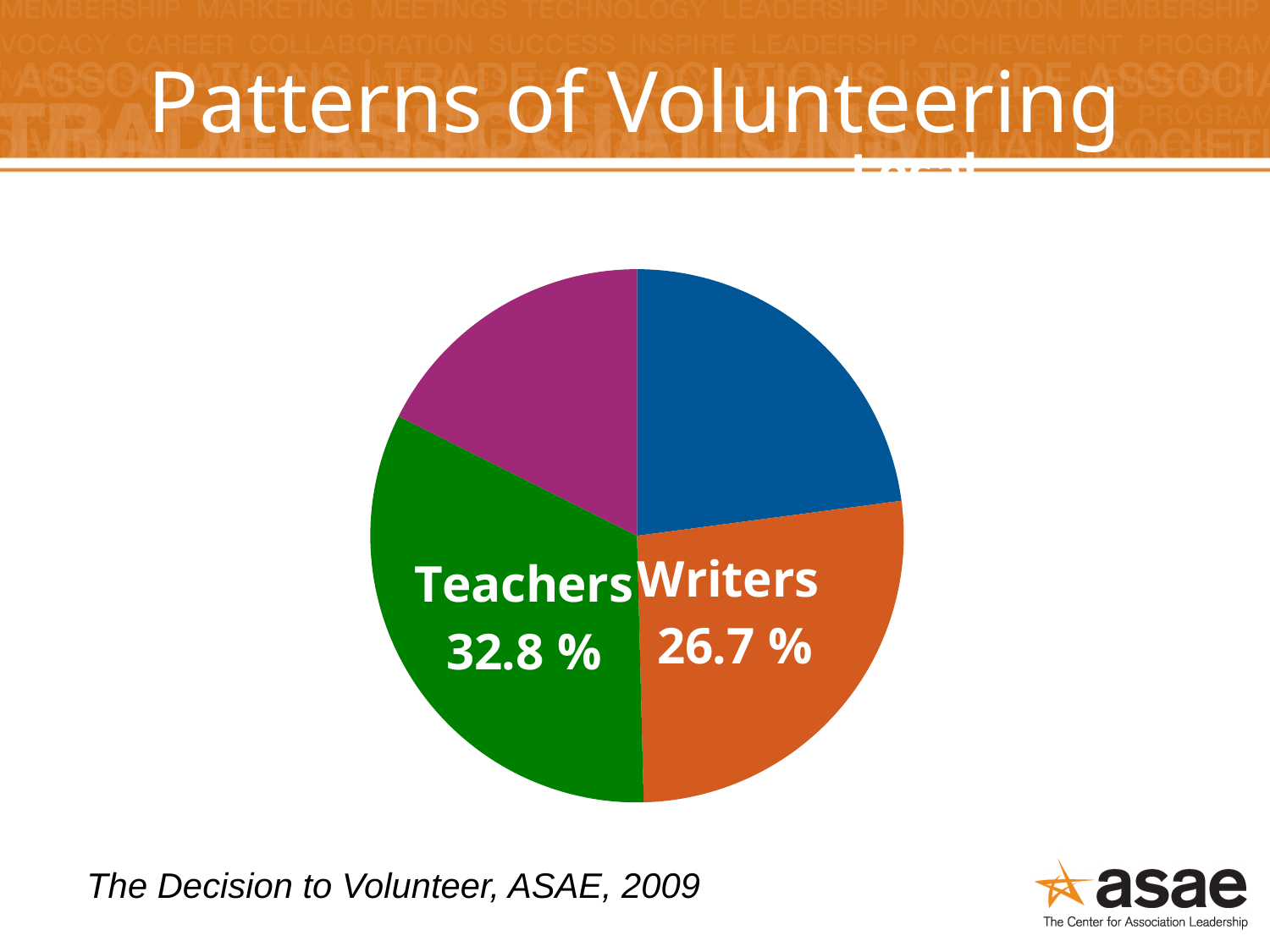
What kind of chart is shown on the slide? pie chart How many slices does the pie chart have? 4 What percentage of the pie is labelled for Writers? 26.7 % Which slice is larger, Teachers or Writers? Teachers Which labelled slice is the largest in the pie chart? Teachers What is the difference between the Teachers share and the Writers share? 6.1 % What is the title of the slide containing the pie chart? Patterns of Volunteering What percentage of the pie is labelled for Teachers? 32.8 % What colour is the Teachers slice of the pie chart? green